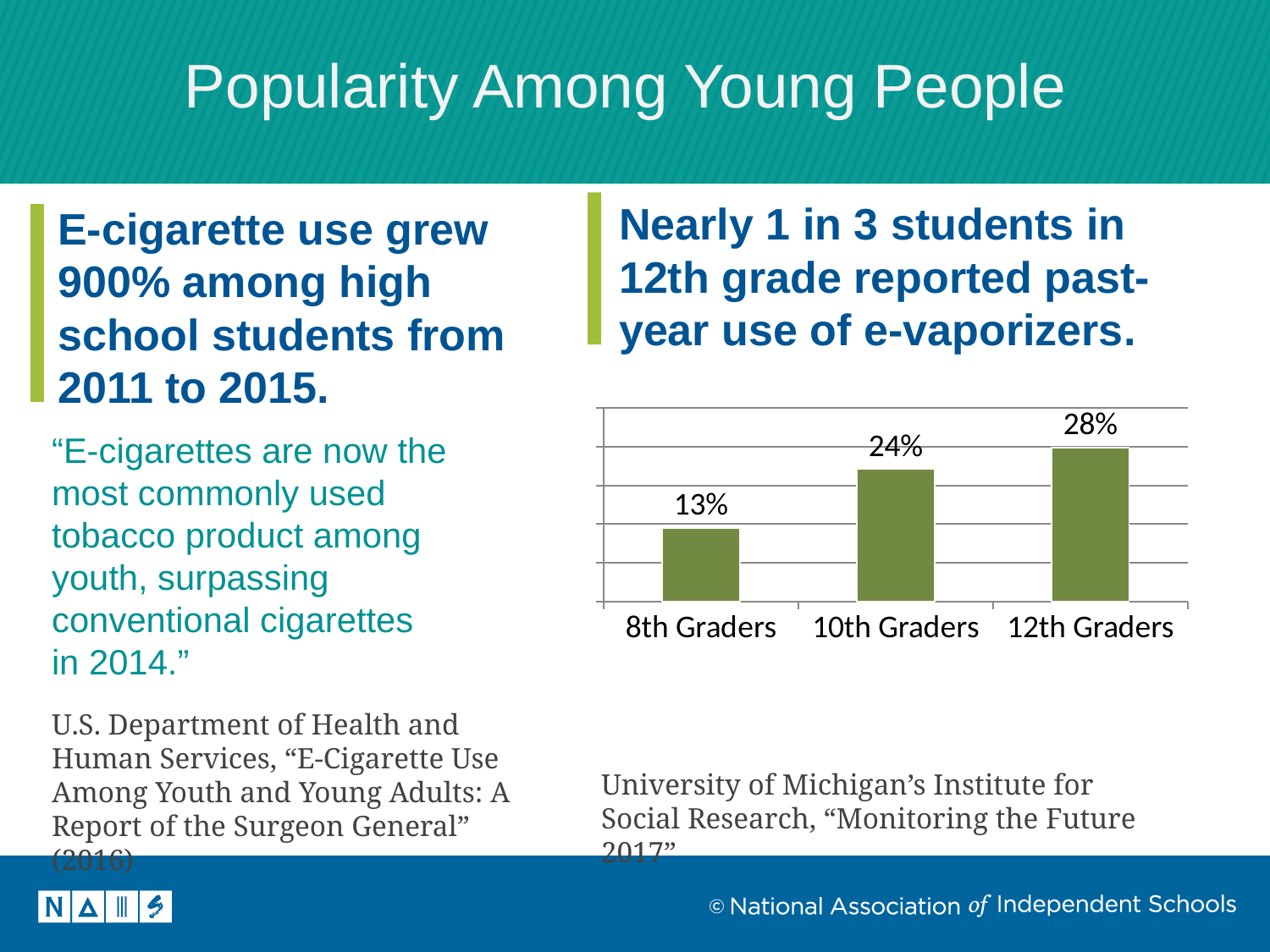
What is the difference between the values for 10th Graders and 8th Graders? 11% What is the value for 10th Graders? 24% How many categories are shown in the chart? 3 Do the values rise or fall from 8th Graders to 12th Graders? rise What is the value for 8th Graders? 13% Which is larger, the value for 10th Graders or the value for 12th Graders? 12th Graders What kind of chart is shown on the slide? bar chart What is the value for 12th Graders? 28% What is the difference between the values for 12th Graders and 8th Graders? 15% Which grade has the highest value? 12th Graders What colour are the bars in the chart? green Which grade has the lowest value? 8th Graders